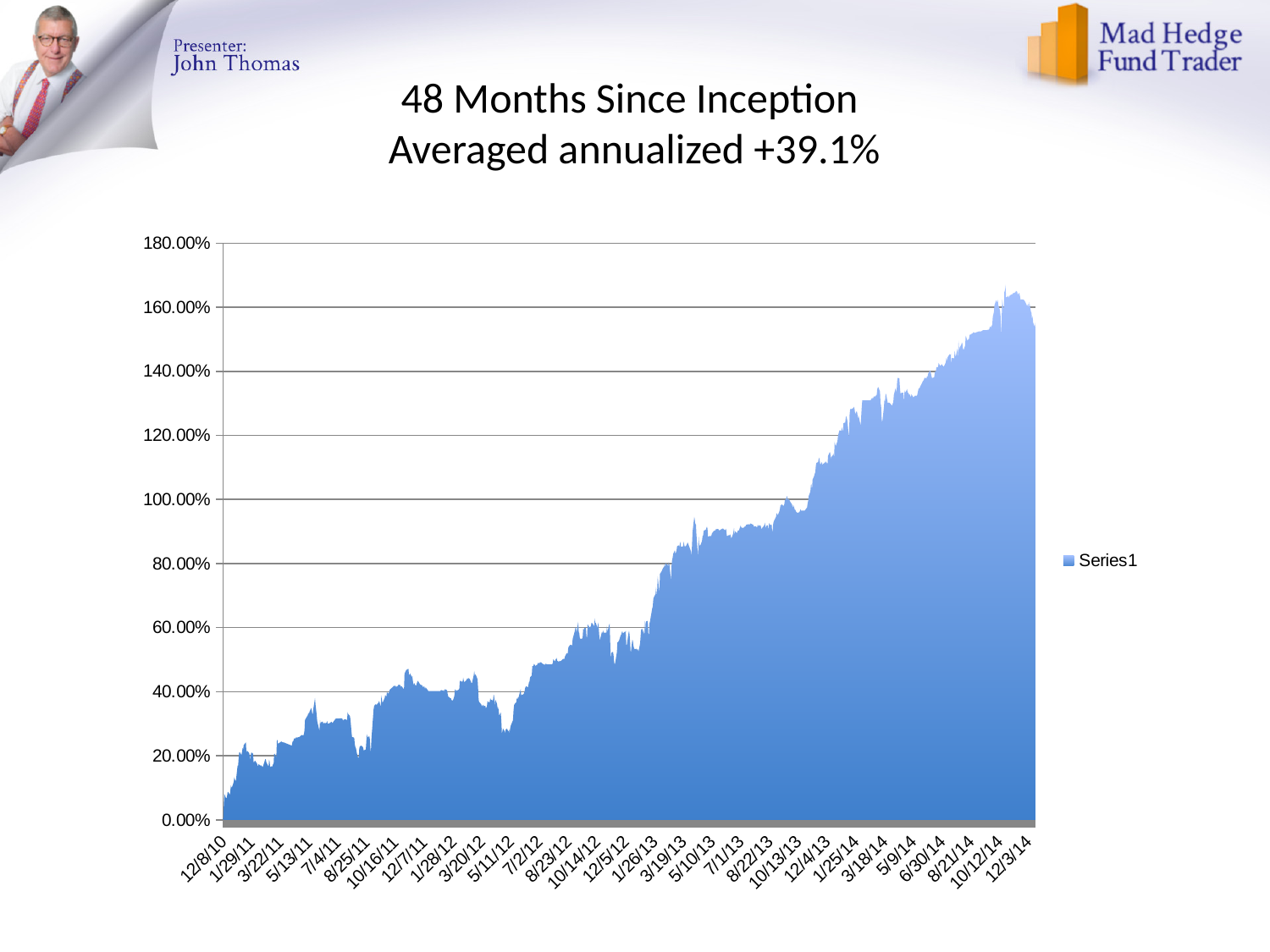
What is the name of the series shown in the legend? Series1 Is the value at 8/25/11 greater or less than 40%? less Is the value at 12/3/14 greater or less than 140%? greater What kind of chart is shown on the slide? Area chart Which of the two dates has the larger value, 3/20/12 or 10/13/13? 10/13/13 How many series does the legend list? 1 Is the highest point on the chart greater or less than 160%? greater What is the highest value shown on the vertical axis? 180.00% Overall, do the values rise or fall from 12/8/10 to 12/3/14? Rise